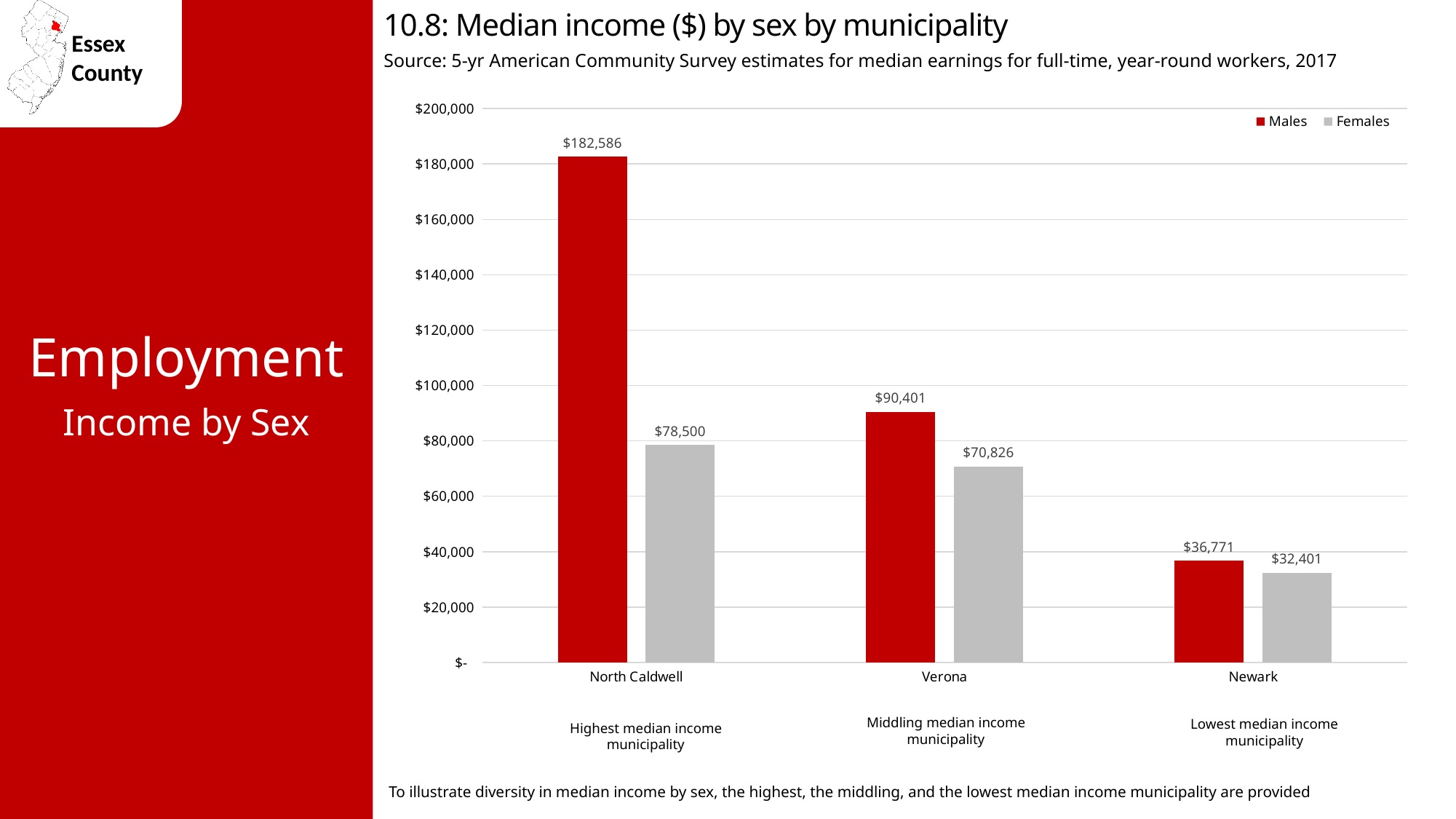
What kind of chart is shown on the slide? Bar chart How many municipalities are shown on the chart? 3 What is the median income for females in Verona? $70,826 What is the difference between male and female median income in North Caldwell? $104,086 How many series does the legend list? 2 Is the female median income in Newark greater or less than $40,000? less What is the difference between male and female median income in Newark? $4,370 What is the median income for males in North Caldwell? $182,586 What is the median income for males in Newark? $36,771 Which is larger: the female median income in North Caldwell or the male median income in Verona? Male median income in Verona Which municipality has the lowest median income for males? Newark Which municipality has the highest median income for females? North Caldwell